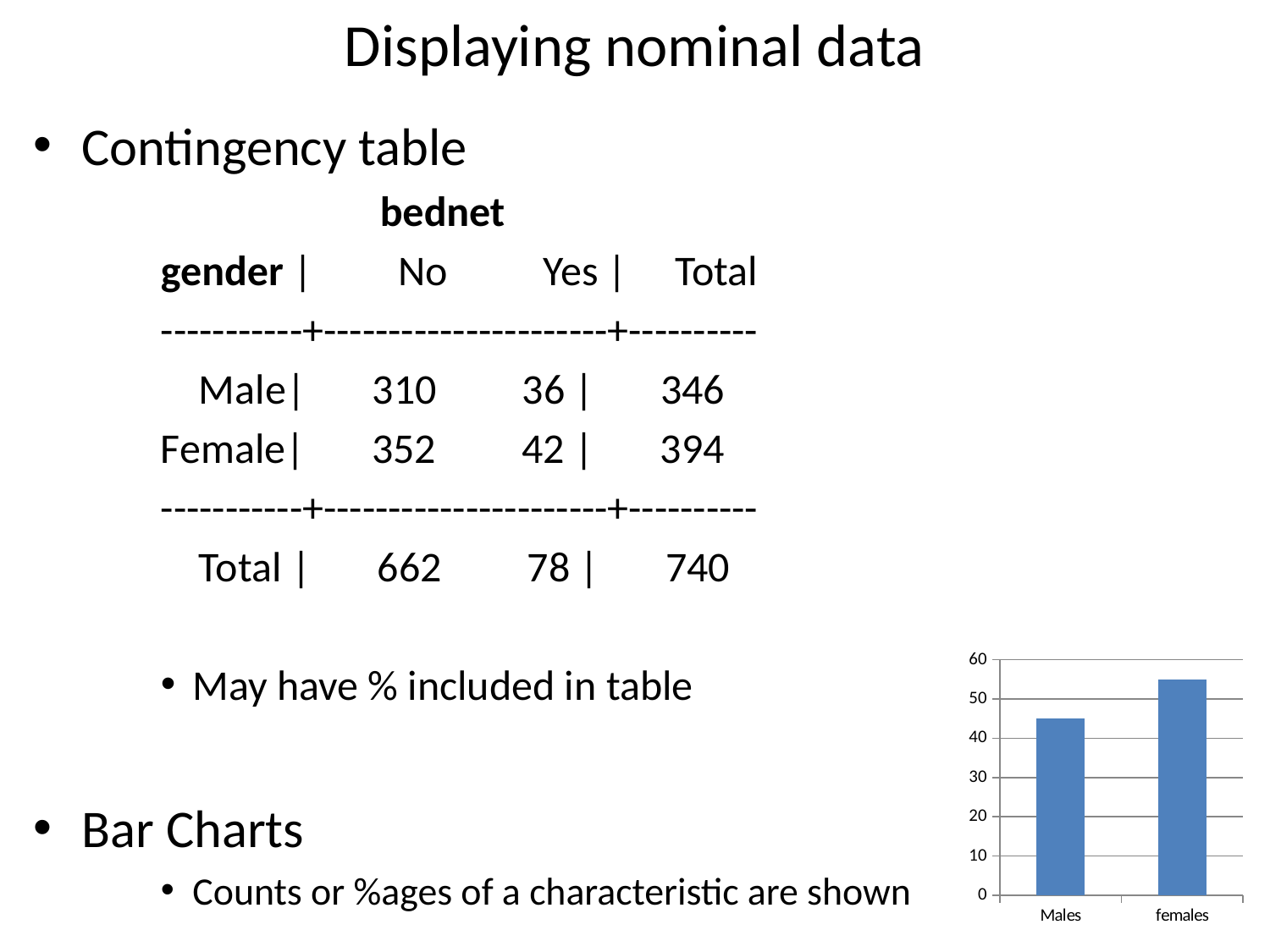
What are the two category labels on the x axis of the chart? Males, females Do the bar values rise or fall from Males to females along the x axis? rise Is the value for females greater or less than 50? greater Which category has the highest bar in the chart? females Is the value for Males greater or less than 40? greater How many categories are shown on the x axis of the bar chart? 2 What is the highest value shown on the chart's vertical axis? 60 What kind of chart is shown on the slide? bar chart Is the value for females greater or less than 60? less Which bar is taller, Males or females? females Which category has the lowest bar in the chart? Males